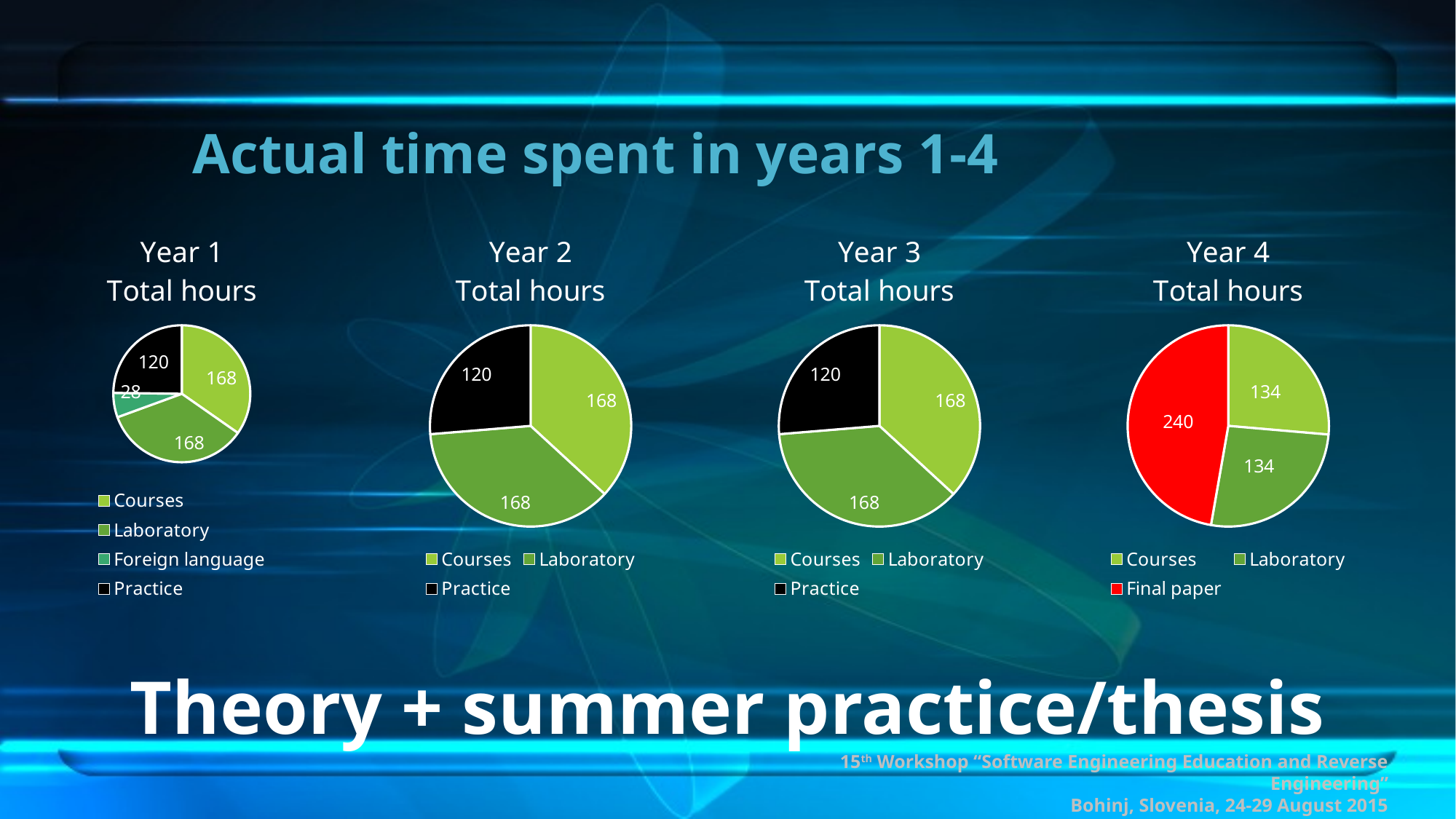
In the Year 4 Total hours chart, what is the difference between the Final paper hours and the Courses hours? 106 What is the total of all slices in the Year 2 Total hours chart? 456 In the Year 3 Total hours chart, what is the difference between the Courses hours and the Practice hours? 48 In the Year 2 Total hours chart, how many hours are shown for Practice? 120 In the Year 1 Total hours chart, which is larger: Practice or Foreign language? Practice In the Year 4 Total hours chart, which category has the largest slice? Final paper In the Year 4 Total hours chart, how many hours are shown for Final paper? 240 How many categories does the legend of the Year 4 Total hours chart list? 3 What type of chart is used for the Year 2 Total hours? Pie chart In the Year 1 Total hours chart, how many hours are shown for Foreign language? 28 How many slices does the Year 1 Total hours pie chart have? 4 In the Year 1 Total hours chart, which category has the smallest slice? Foreign language